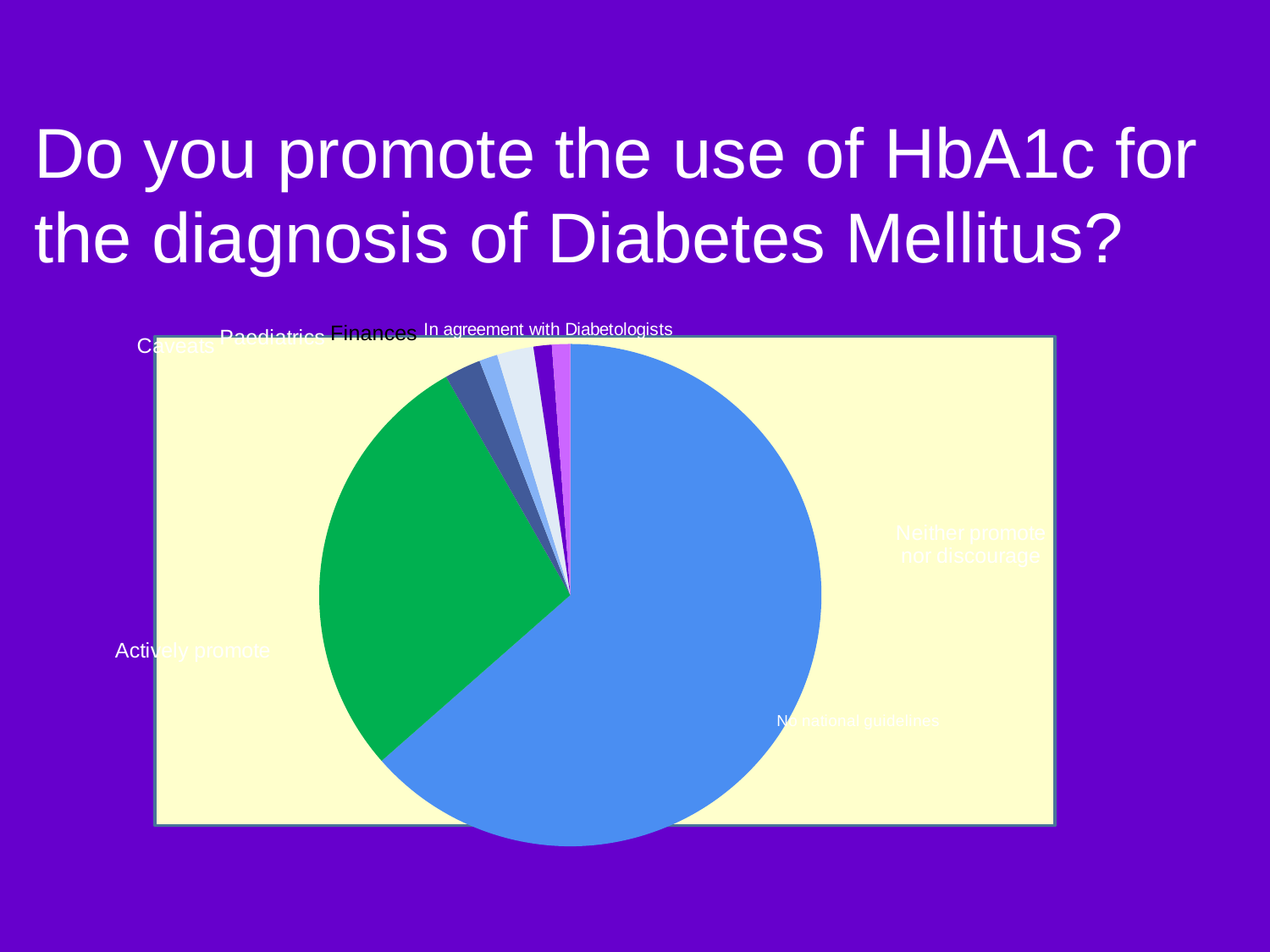
Which is larger, the slice for Actively promote or the slice for Caveats? Actively promote Which category has the largest slice of the pie? Neither promote nor discourage Which is larger, the slice for Neither promote nor discourage or the slice for Paediatrics? Neither promote nor discourage What kind of chart is shown on the slide? pie chart Which category has the second-largest slice of the pie? Actively promote Which is larger, the slice for Neither promote nor discourage or the slice for Actively promote? Neither promote nor discourage What is the title of the slide containing the pie chart? Do you promote the use of HbA1c for the diagnosis of Diabetes Mellitus? What colour is the slice for Actively promote? green How many categories are labelled on the pie chart? 7